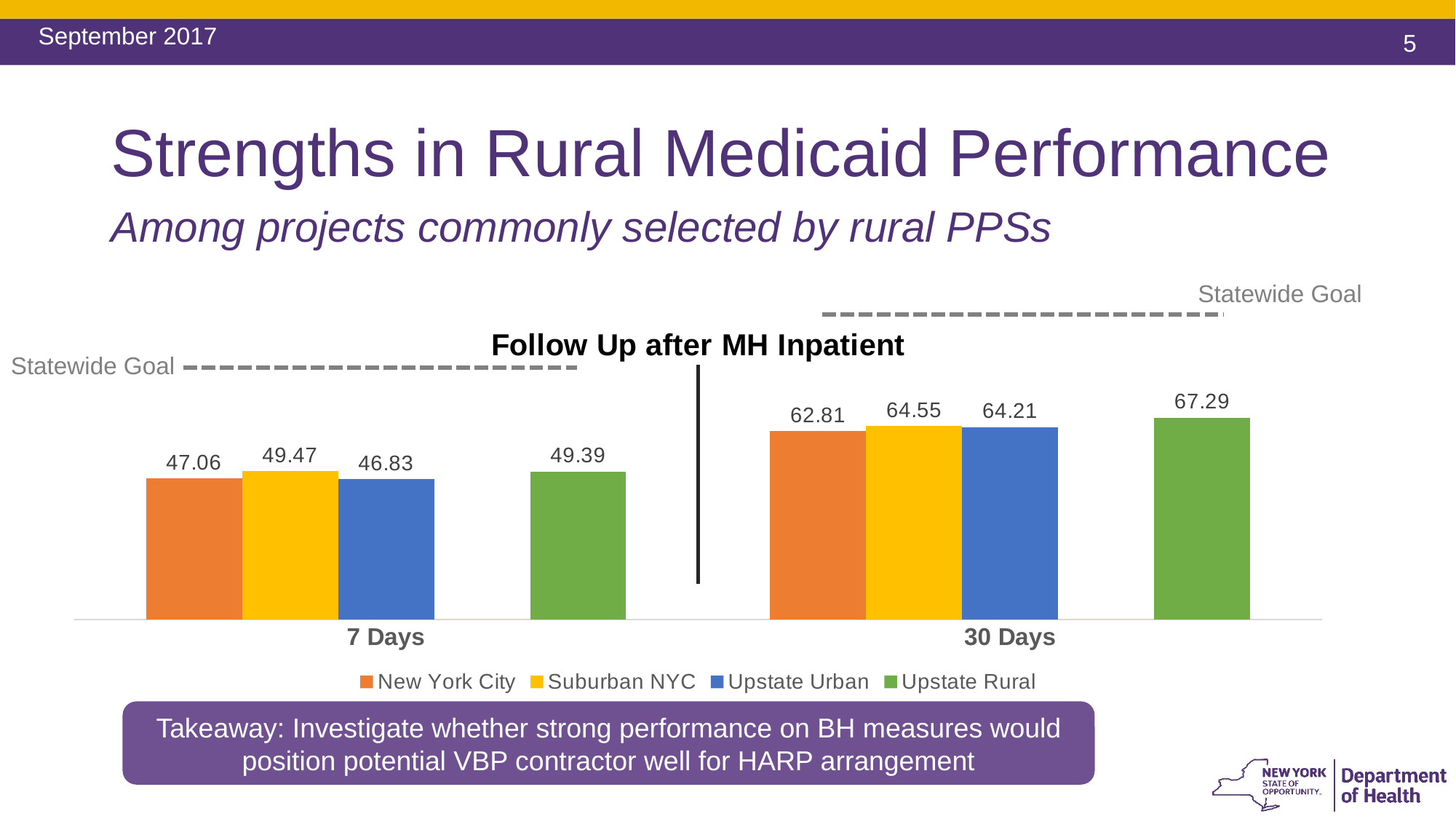
Which region has the highest value at 30 Days? Upstate Rural What kind of chart is shown on the slide? Bar chart What is the difference between Upstate Rural and New York City at 30 Days? 4.48 What is the title of the chart? Follow Up after MH Inpatient What is the value for Upstate Rural at 7 Days? 49.39 Which is larger at 7 Days: New York City or Upstate Urban? New York City What is the value for Upstate Urban at 30 Days? 64.21 What is the value for New York City at 30 Days? 62.81 Which region has the lowest value at 7 Days? Upstate Urban How many series does the legend list? 4 How many categories are shown on the x axis? 2 What is the value for Suburban NYC at 7 Days? 49.47